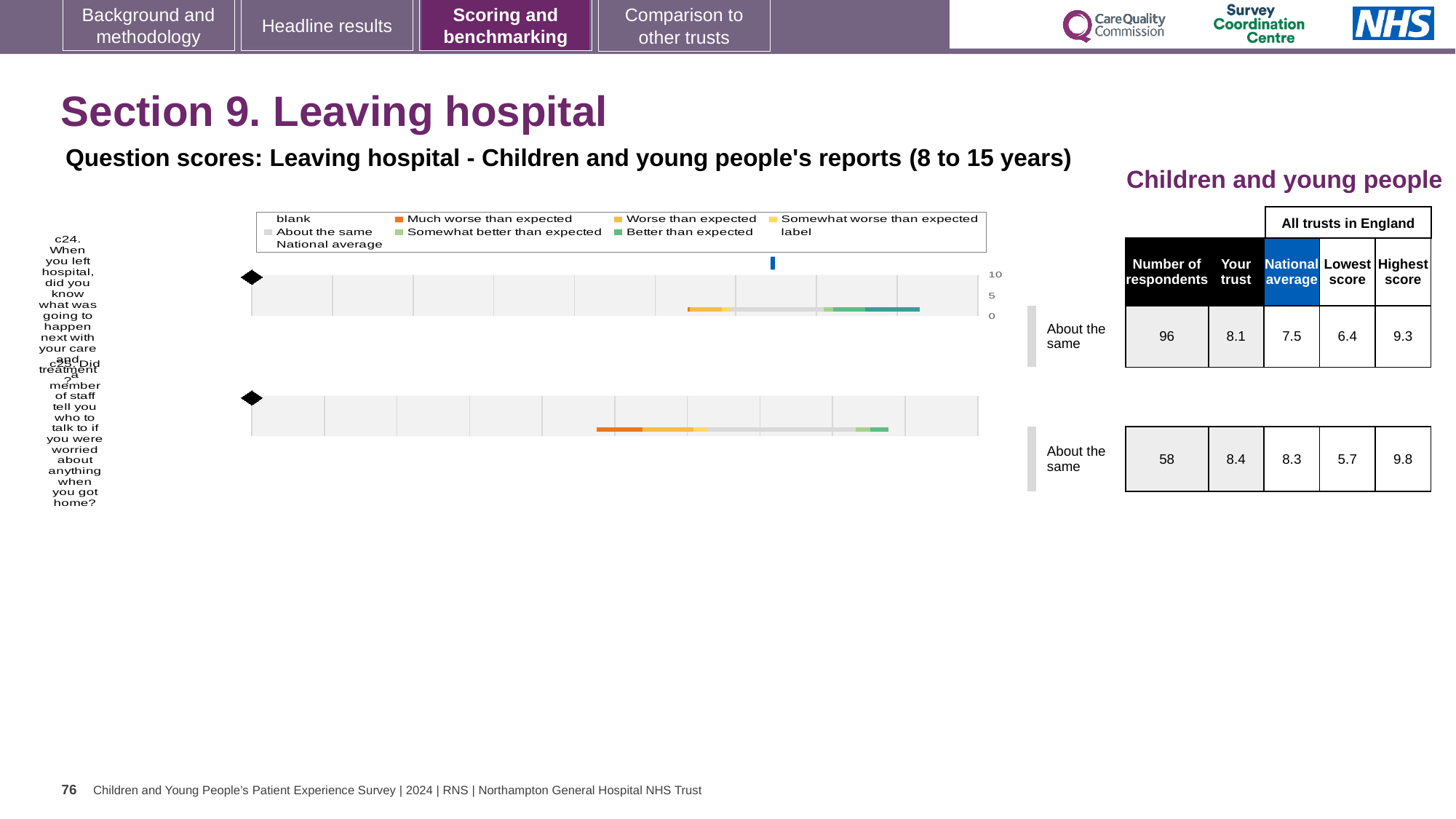
For question c24, what is the national average score shown? 7.5 What kind of chart is used to show the question scores on this slide? bar chart How many survey questions (c24 and c25) are plotted as bars on this slide? 2 For question c24, how many respondents are shown in the table next to the chart? 96 For question c24, what is the 'Your trust' score shown? 8.1 For question c24, what is the difference between the 'Your trust' score and the national average? 0.6 For question c25, what is the 'Your trust' score shown? 8.4 For question c25, what is the difference between the highest score (9.8) and the lowest score (5.7)? 4.1 For question c25, what is the highest score among all trusts in England? 9.8 In the legend, what colour represents 'Much worse than expected'? orange What benchmark category label is shown for question c25? About the same For question c24, which is larger: the 'Your trust' score or the national average? Your trust